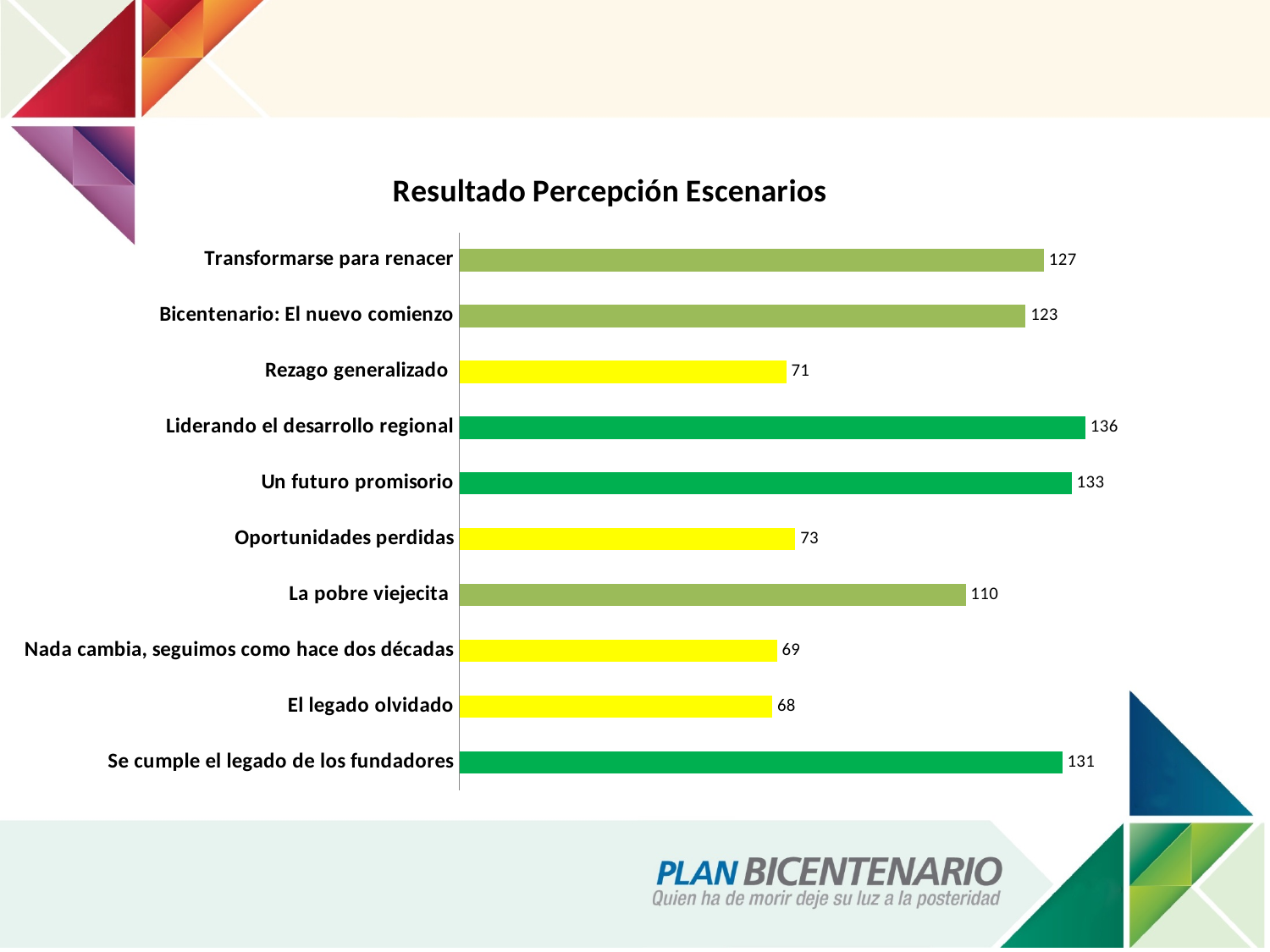
What kind of chart is this? Bar chart Which category has the lowest value? El legado olvidado What is the value for "Liderando el desarrollo regional"? 136 What is the difference between "Transformarse para renacer" and "Bicentenario: El nuevo comienzo"? 4 What is the title of the chart? Resultado Percepción Escenarios Which is larger, "Se cumple el legado de los fundadores" or "La pobre viejecita"? Se cumple el legado de los fundadores How many categories are shown in the chart? 10 What is the difference between "Un futuro promisorio" and "Oportunidades perdidas"? 60 What colour is the bar for "Nada cambia, seguimos como hace dos décadas"? Yellow Which category has the highest value? Liderando el desarrollo regional What is the value for "La pobre viejecita"? 110 What is the value for "Rezago generalizado"? 71